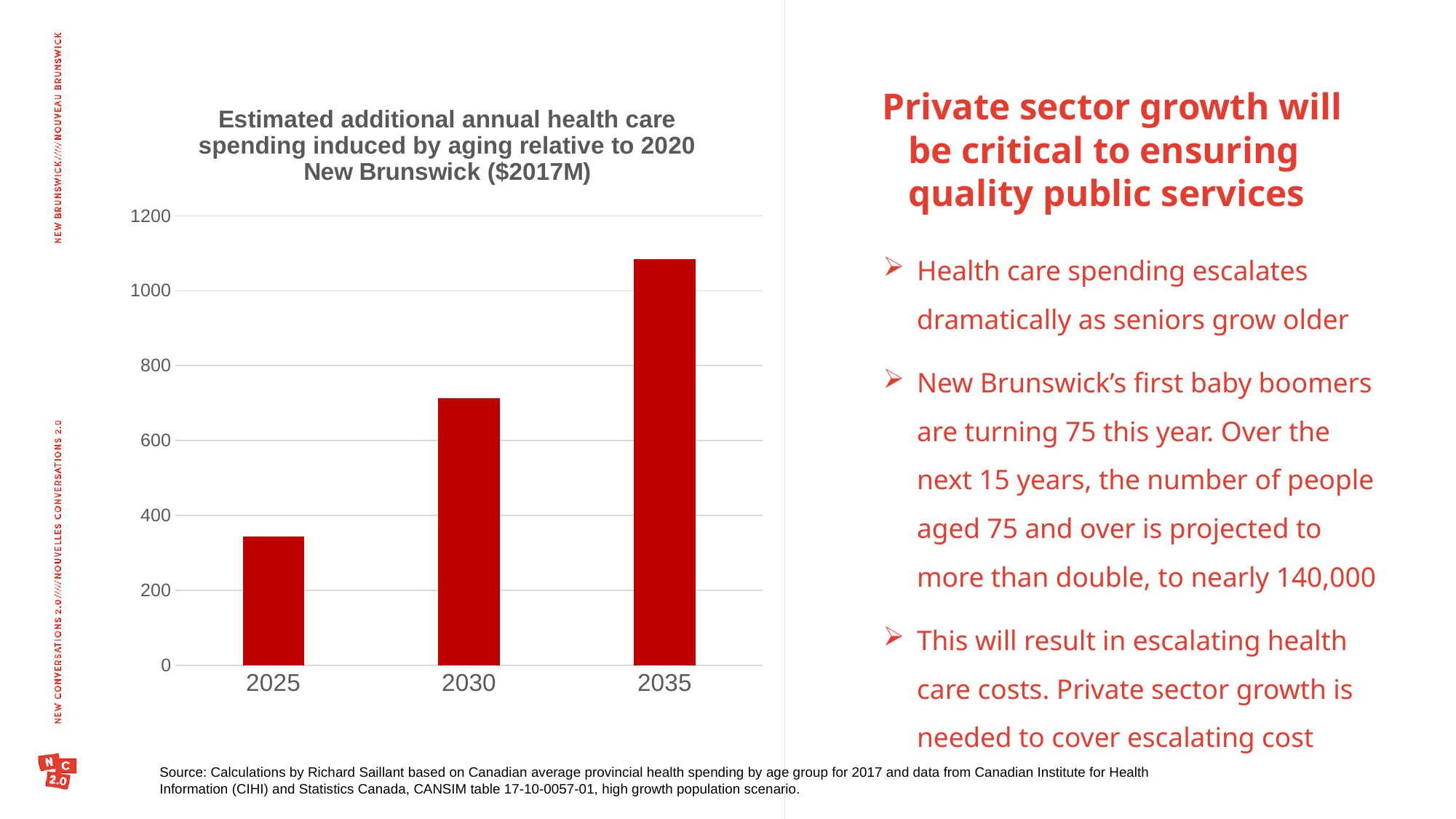
Do the values rise or fall from 2025 to 2035? rise Which year has the lowest estimated additional annual health care spending? 2025 Is the value for 2035 greater or less than 1000? greater Is the value for 2030 greater or less than 800? less What is the highest value shown on the vertical axis? 1200 In what units are the values on the chart expressed, according to the title? $2017M What kind of chart is shown on the slide? bar chart How many years are plotted on the chart? 3 Which is larger, the value for 2030 or the value for 2035? 2035 Is the value for 2025 greater or less than 400? less Which year has the highest estimated additional annual health care spending? 2035